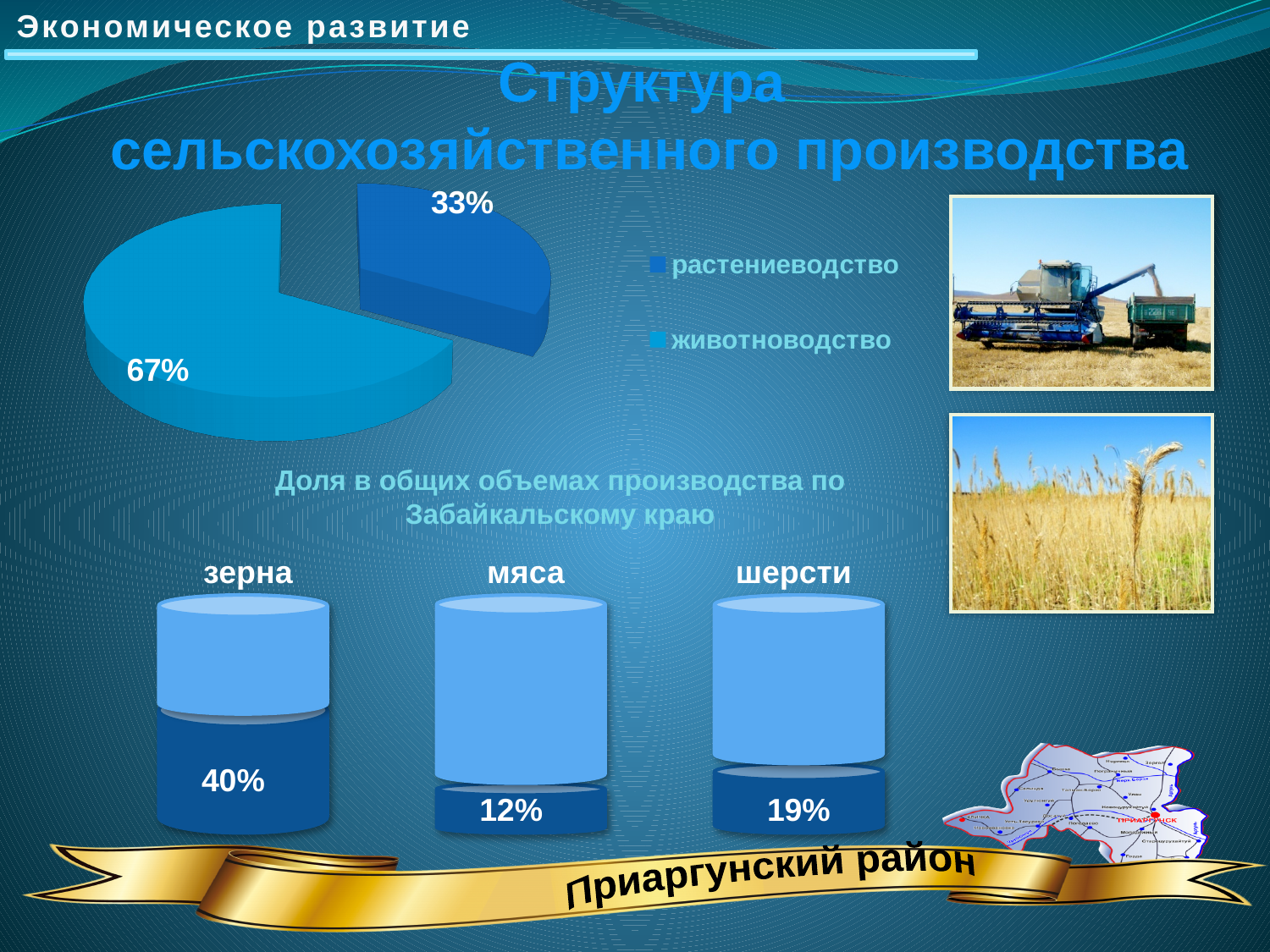
In the pie chart 'Структура сельскохозяйственного производства', what share does 'растениеводство' have? 33% In the pie chart 'Структура сельскохозяйственного производства', which category has the largest share? животноводство In the pie chart 'Структура сельскохозяйственного производства', what share does 'животноводство' have? 67% In the pie chart 'Структура сельскохозяйственного производства', by how many percentage points does 'животноводство' exceed 'растениеводство'? 34 In the chart 'Доля в общих объемах производства по Забайкальскому краю', which is larger, the value for 'шерсти' or for 'мяса'? шерсти In the chart 'Доля в общих объемах производства по Забайкальскому краю', what is the value for 'шерсти'? 19% What kind of chart is the chart titled 'Структура сельскохозяйственного производства'? pie chart In the chart 'Доля в общих объемах производства по Забайкальскому краю', what is the value for 'мяса'? 12% In the chart 'Доля в общих объемах производства по Забайкальскому краю', which category has the lowest value? мяса In the pie chart 'Структура сельскохозяйственного производства', how many entries does the legend list? 2 In the chart 'Доля в общих объемах производства по Забайкальскому краю', how many categories are shown? 3 In the chart 'Доля в общих объемах производства по Забайкальскому краю', what is the value for 'зерна'? 40%